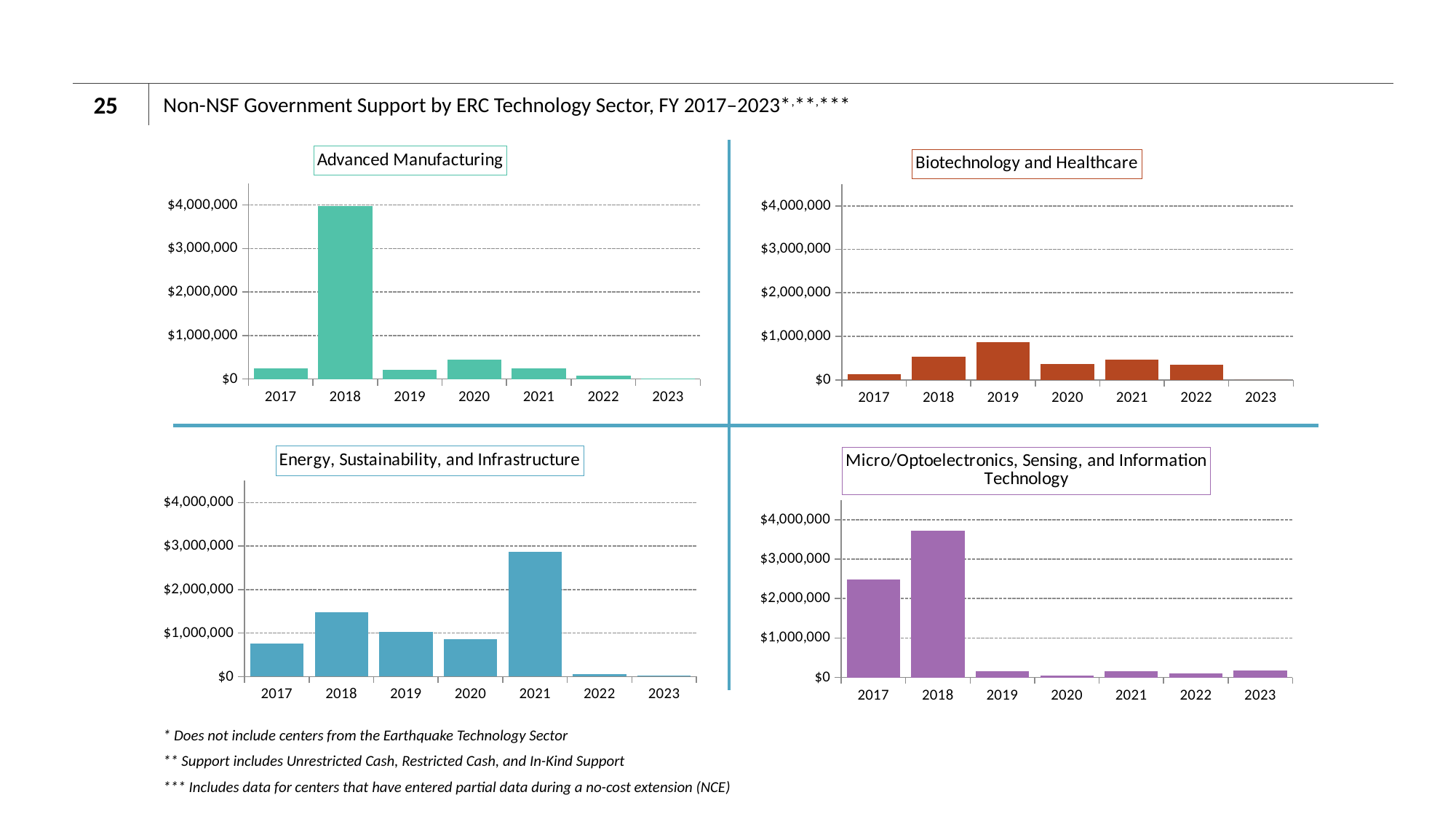
In the Biotechnology and Healthcare chart, is the value for 2019 greater or less than $1,000,000? less In the Energy, Sustainability, and Infrastructure chart, which year has the highest value? 2021 In the Micro/Optoelectronics, Sensing, and Information Technology chart, which year has the highest value? 2018 In the Advanced Manufacturing chart, which is larger, the value for 2020 or the value for 2021? 2020 In the Advanced Manufacturing chart, is the value for 2018 greater or less than $3,000,000? greater In the Advanced Manufacturing chart, which year has the highest value? 2018 How many years are shown on the x axis of the Biotechnology and Healthcare chart? 7 In the Micro/Optoelectronics, Sensing, and Information Technology chart, is the value for 2017 greater or less than $2,000,000? greater What type of chart is the Energy, Sustainability, and Infrastructure chart? bar chart